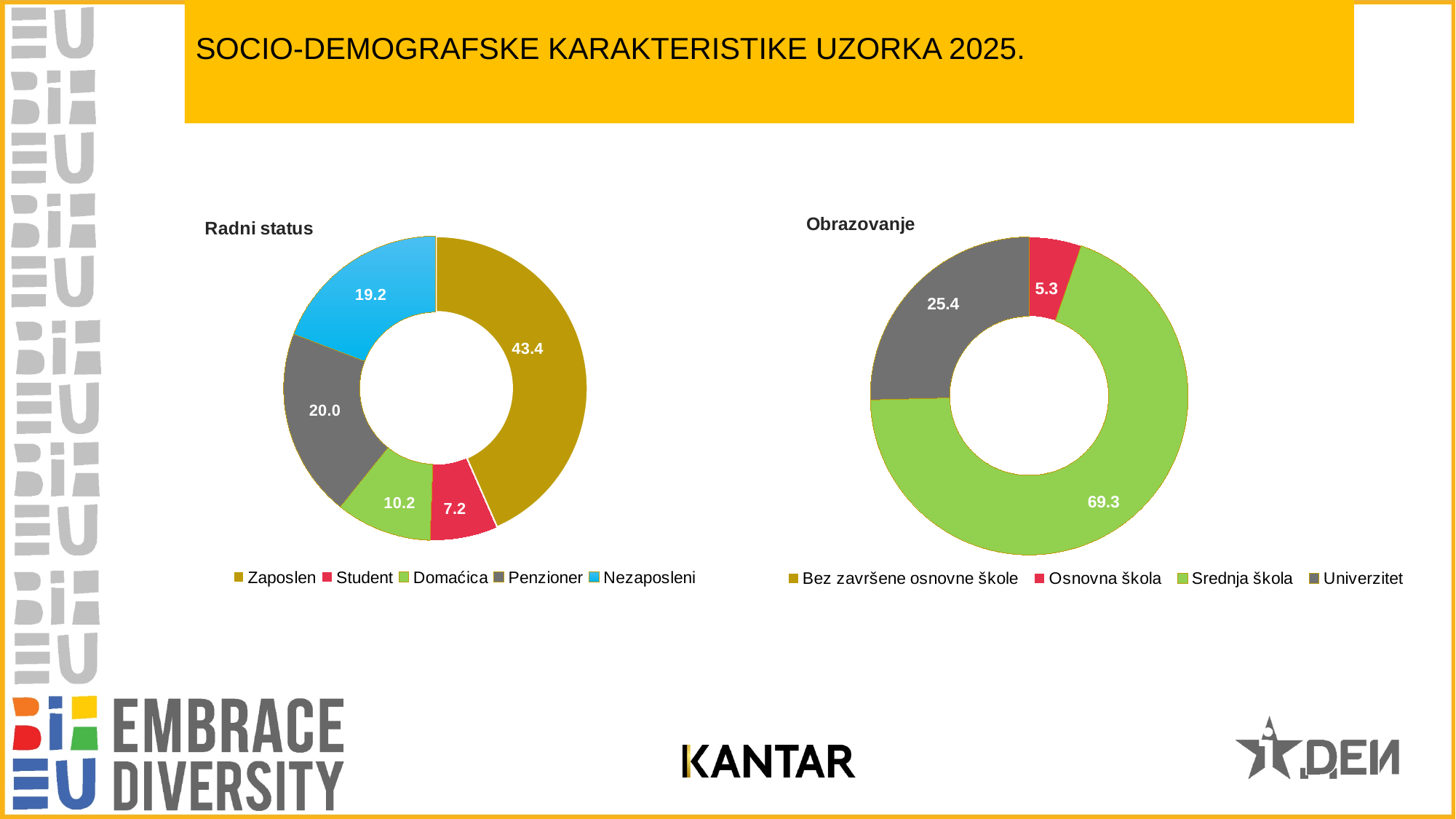
In the 'Obrazovanje' chart, what is the difference between the values for Srednja škola and Univerzitet? 43.9 In the 'Radni status' chart, what is the difference between the values for Nezaposleni and Domaćica? 9.0 In the 'Radni status' chart, what is the value for Penzioner? 20.0 In the 'Radni status' chart, which category has the largest share? Zaposlen What kind of chart is the 'Obrazovanje' chart? Doughnut (pie) chart In the 'Obrazovanje' chart, what is the value for Univerzitet? 25.4 In the 'Radni status' chart, which category has the smallest share? Student In the 'Obrazovanje' chart, what is the value for Srednja škola? 69.3 How many entries does the legend of the 'Radni status' chart list? 5 In the 'Radni status' chart, what is the value for Zaposlen? 43.4 In the 'Obrazovanje' chart, which is larger, Osnovna škola or Univerzitet? Univerzitet In the 'Radni status' chart, what is the value for Student? 7.2